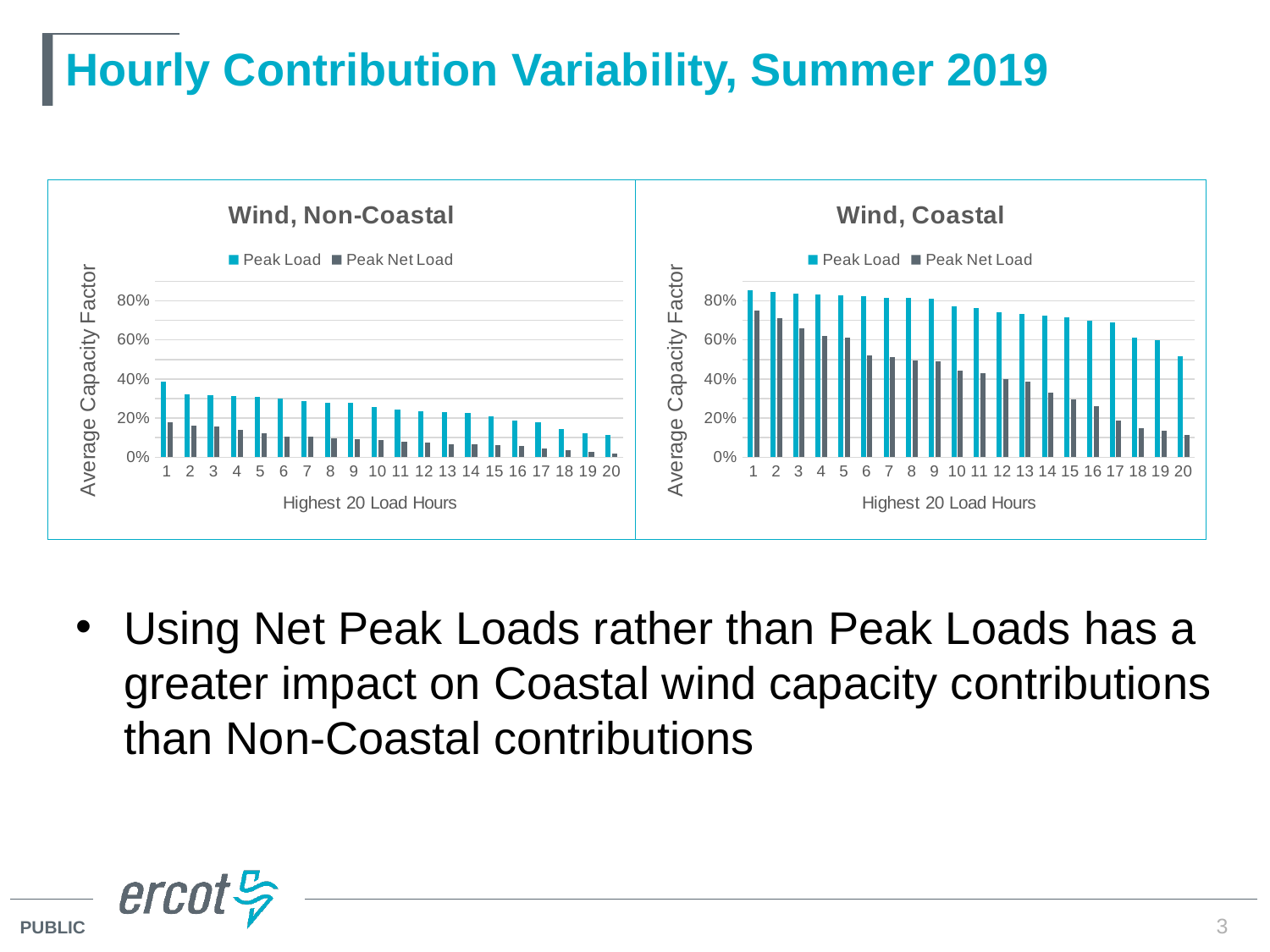
How many load hours are shown on the x axis of the "Wind, Non-Coastal" chart? 20 In the "Wind, Coastal" chart, is the Peak Load value for hour 1 greater or less than 80%? greater In the "Wind, Coastal" chart, is the Peak Net Load value for hour 20 greater or less than 20%? less Which chart has the larger Peak Load value for hour 1, "Wind, Non-Coastal" or "Wind, Coastal"? Wind, Coastal In the "Wind, Coastal" chart, which load hour has the lowest Peak Net Load value? 20 In the "Wind, Non-Coastal" chart, which load hour has the highest Peak Load value? 1 What kind of chart is the "Wind, Non-Coastal" chart? Bar chart How many series does the legend of the "Wind, Coastal" chart list? 2 In the "Wind, Coastal" chart, is the Peak Load value for hour 20 greater or less than 40%? greater In the "Wind, Coastal" chart, do the Peak Load values rise or fall from hour 1 to hour 20? Fall What is the y-axis label of the "Wind, Coastal" chart? Average Capacity Factor